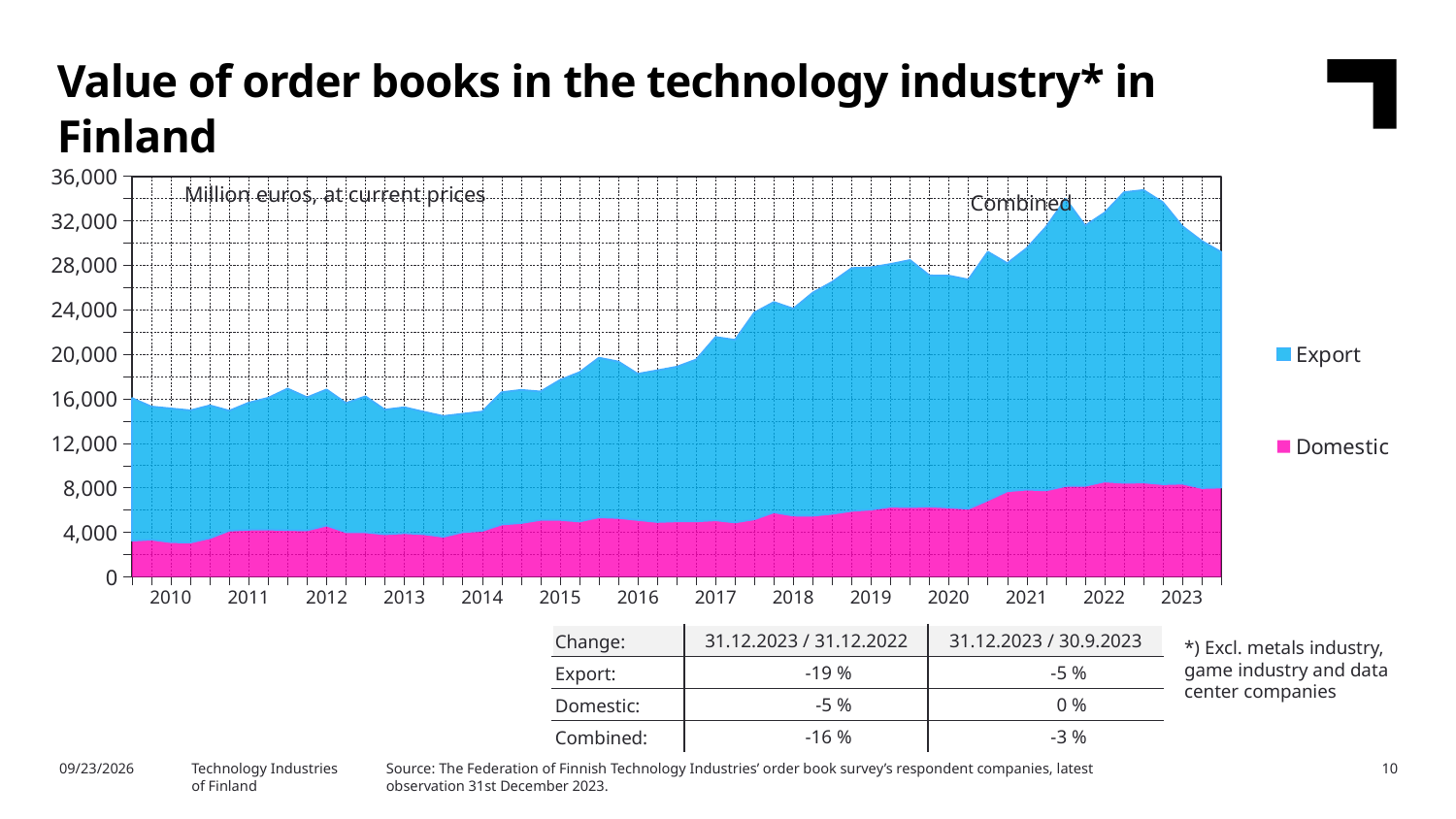
Is the combined value at the start of 2010 greater or less than 20,000? less In which year does the combined value reach its highest point? 2022 Is the combined value at the peak in 2022 greater or less than 32,000? greater Is the Domestic value in 2022 greater or less than 4,000? greater Which series is larger throughout the chart, Export or Domestic? Export How many series does the chart legend list? 2 Does the combined value generally rise or fall from 2014 to 2022? rise What unit is stated for the values in the chart? Million euros, at current prices What kind of chart is shown on the slide? Area chart Which two series are listed in the chart legend? Export and Domestic How many year labels are shown on the x axis? 14